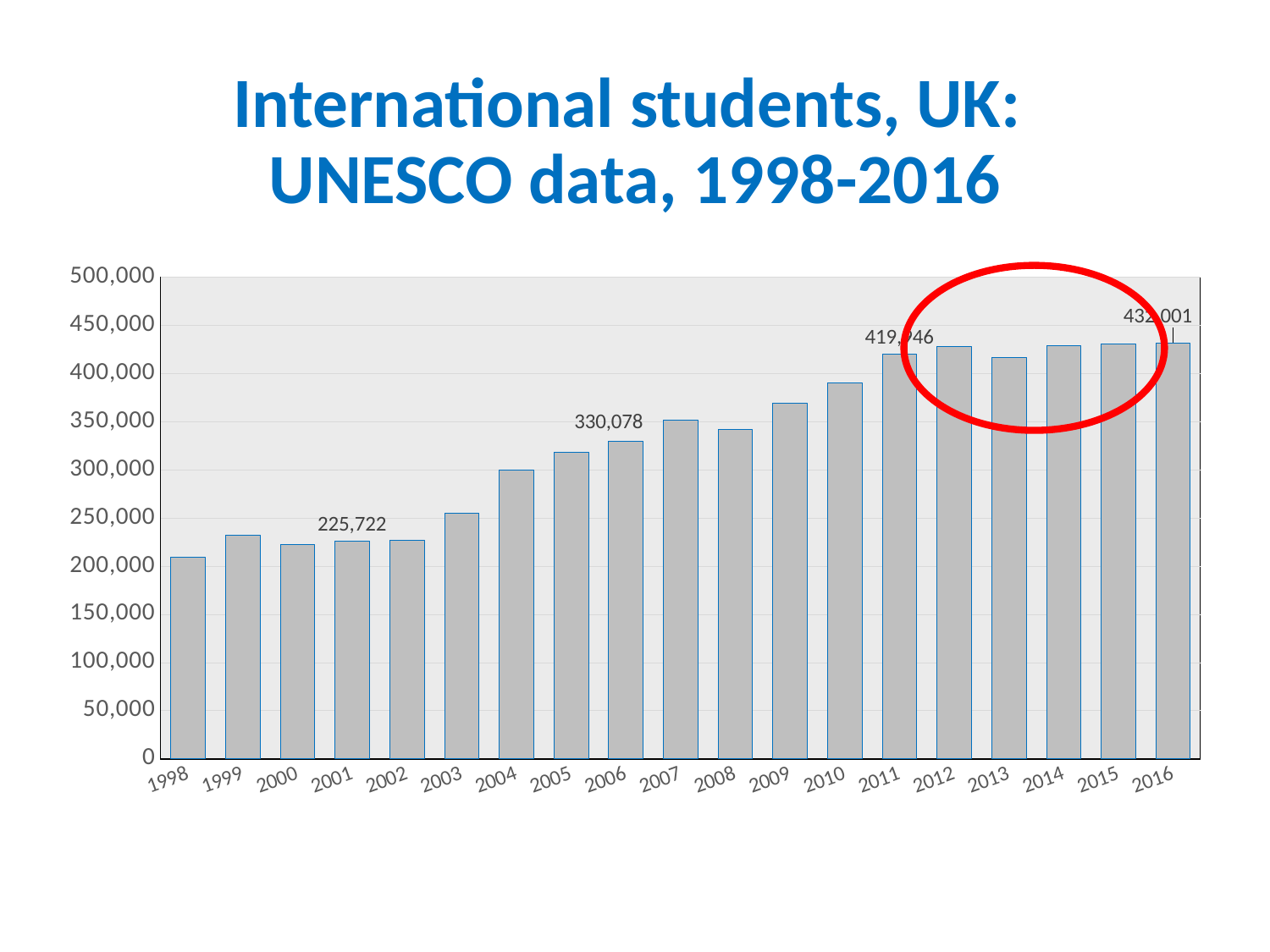
What kind of chart is shown on the slide? bar chart What is the difference between the values for 2016 and 2006? 101,923 Is the value for 2010 greater or less than 350,000? greater What is the value for 2016? 432,001 Which year has the lowest value? 1998 Which is larger, the value for 2003 or the value for 2004? 2004 Which is larger, the value for 2007 or the value for 2008? 2007 What is the value for 2006? 330,078 How many years are shown on the x axis? 19 Is the value for 1998 greater or less than 250,000? less What is the value for 2001? 225,722 What is the difference between the values for 2006 and 2001? 104,356